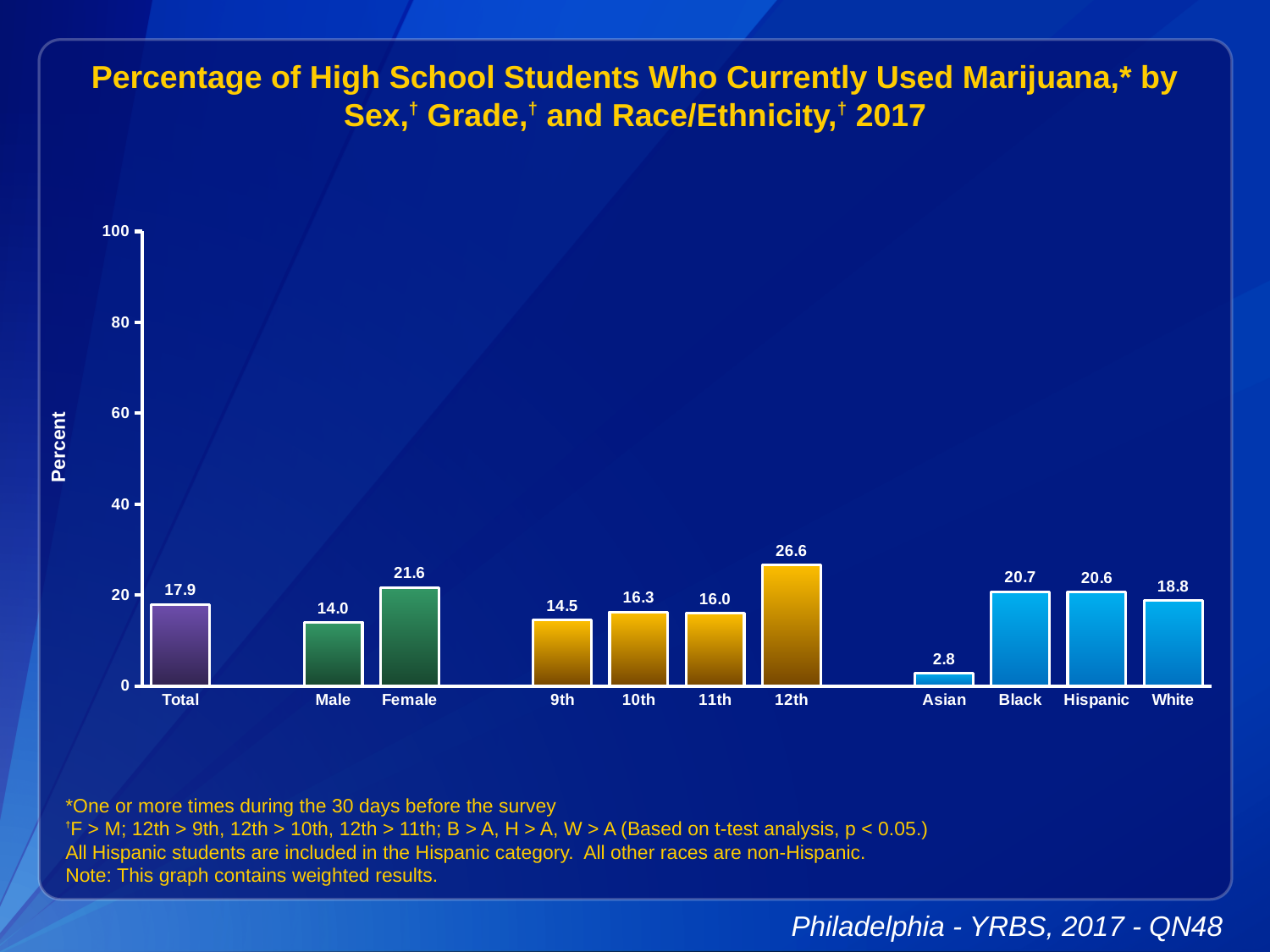
What kind of chart is this? bar chart Which category has the highest value? 12th What is the difference between the Female and Male values? 7.6 Which is larger, the value for Black or the value for White? Black What is the value for Asian? 2.8 Do the values rise or fall from 9th grade to 12th grade? rise How many categories are shown on the x axis? 11 What is the value for Total? 17.9 Which category has the lowest value? Asian Is the value for 12th grade greater or less than 20? greater What is the value for 12th grade? 26.6 What is the value for Female? 21.6